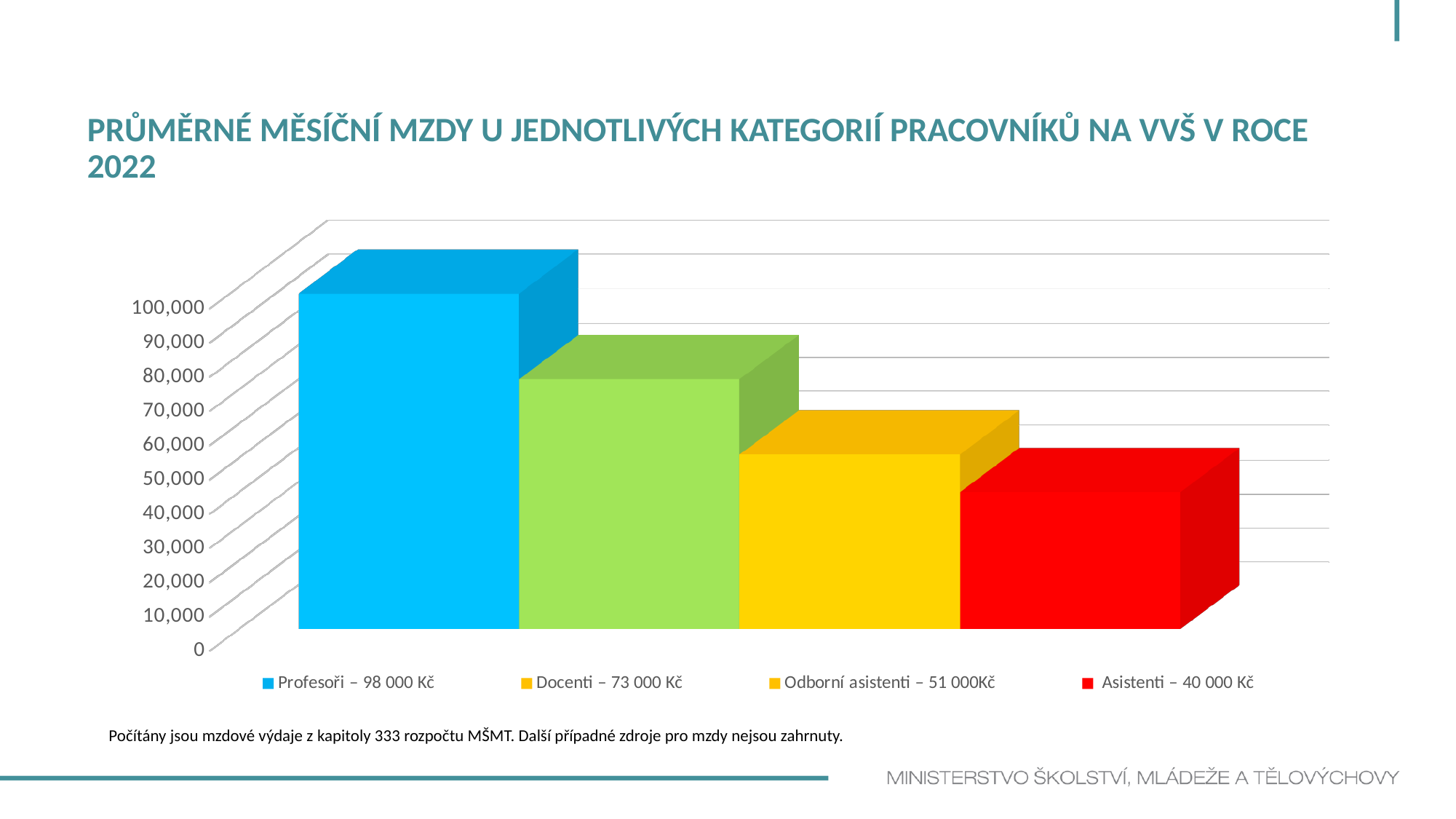
What is the difference between the salary of Profesoři and Docenti? 25 000 Kč How many categories of workers are shown in the chart? 4 Which category has the highest average monthly salary? Profesoři Which is larger, the salary of Docenti or of Odborní asistenti? Docenti What kind of chart is shown on the slide? Bar chart What is the average monthly salary shown for Odborní asistenti? 51 000Kč What is the average monthly salary shown for Docenti? 73 000 Kč Do the values rise or fall from left to right across the bars? Fall What is the difference between the salary of Odborní asistenti and Asistenti? 11 000 Kč Which category has the lowest average monthly salary? Asistenti What is the average monthly salary shown for Asistenti? 40 000 Kč What is the average monthly salary shown for Profesoři? 98 000 Kč